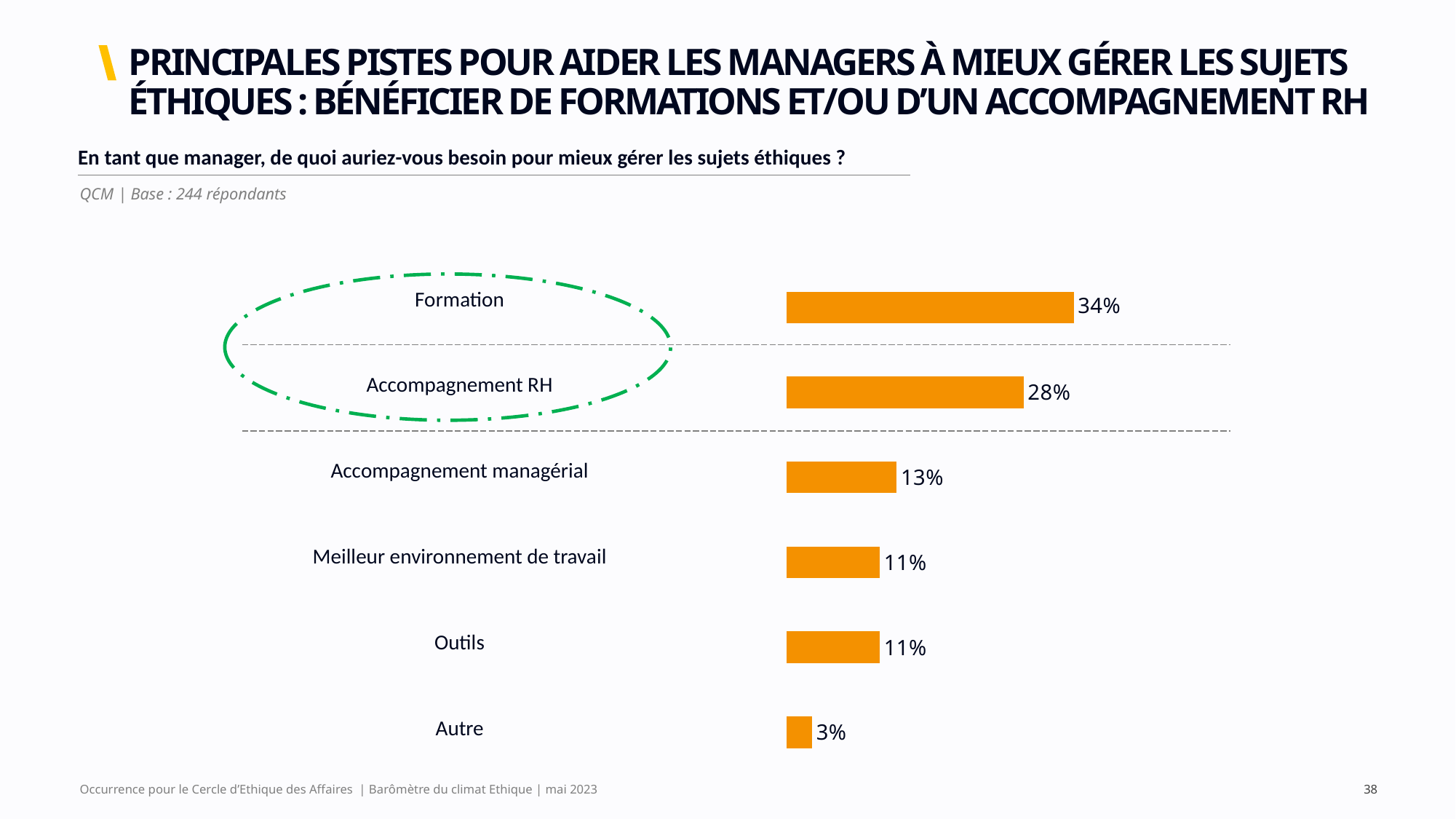
What is the difference between the values for Formation and Accompagnement RH? 6% What is the value for Formation? 34% What is the value for Accompagnement RH? 28% Which two categories are circled with a green dashed outline? Formation and Accompagnement RH What kind of chart is shown on the slide? Bar chart Which category has the highest value? Formation What is the difference between the values for Accompagnement managérial and Outils? 2% Which is larger, the value for Accompagnement RH or the value for Accompagnement managérial? Accompagnement RH Which category has the lowest value? Autre What is the value for Autre? 3% What is the value for Accompagnement managérial? 13% How many categories are shown in the chart? 6